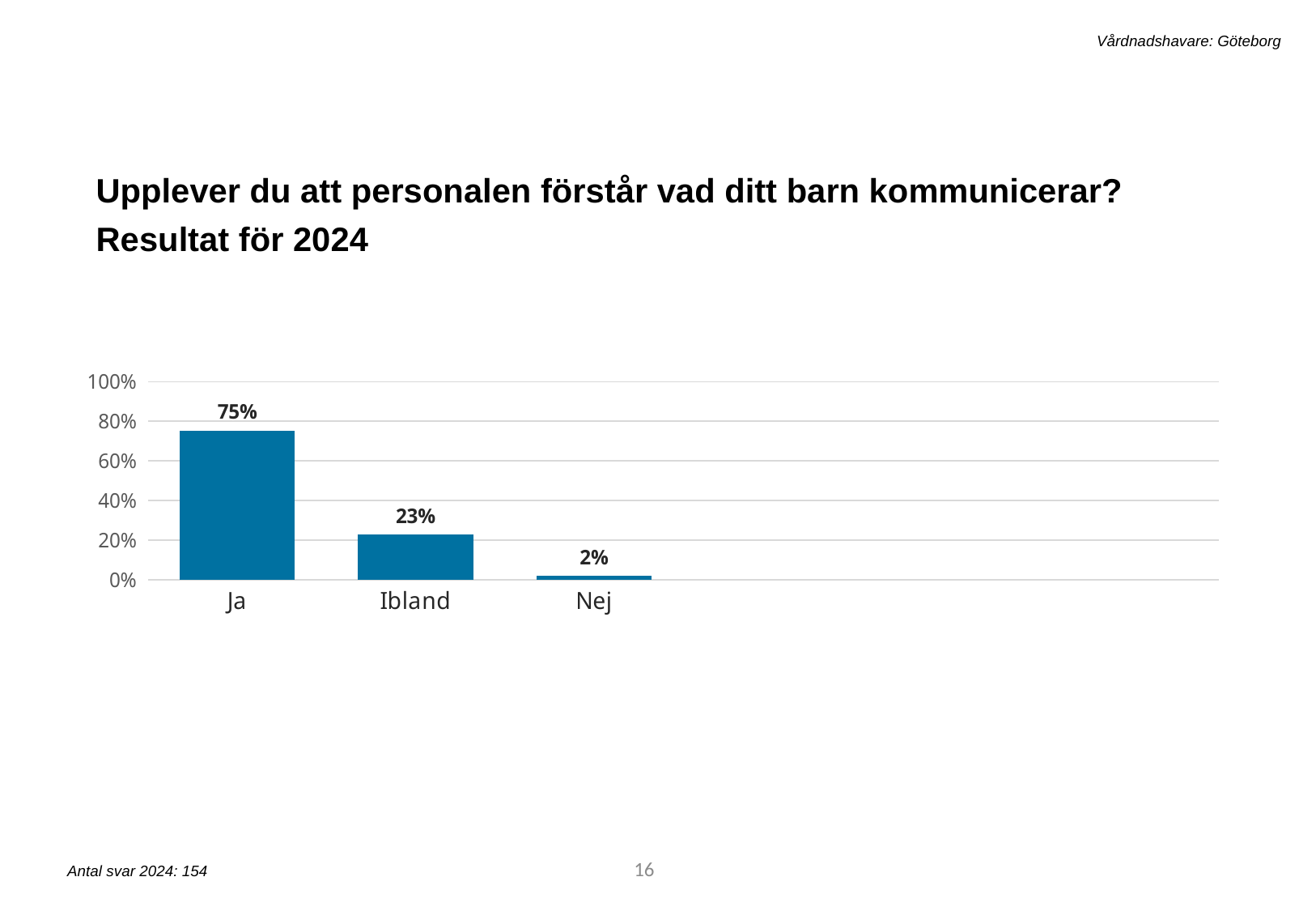
What is the value for Ja? 75% Which category has the highest value? Ja What is the difference between the values for Ja and Ibland? 52% What is the value for Nej? 2% Which is larger, the value for Ibland or the value for Nej? Ibland What is the value for Ibland? 23% What kind of chart is shown on the slide? bar chart How many categories are shown on the x axis? 3 What is the difference between the values for Ibland and Nej? 21% Which category has the lowest value? Nej Do the values rise or fall from left to right along the x axis? fall Is the value for Ja greater or less than 60%? greater